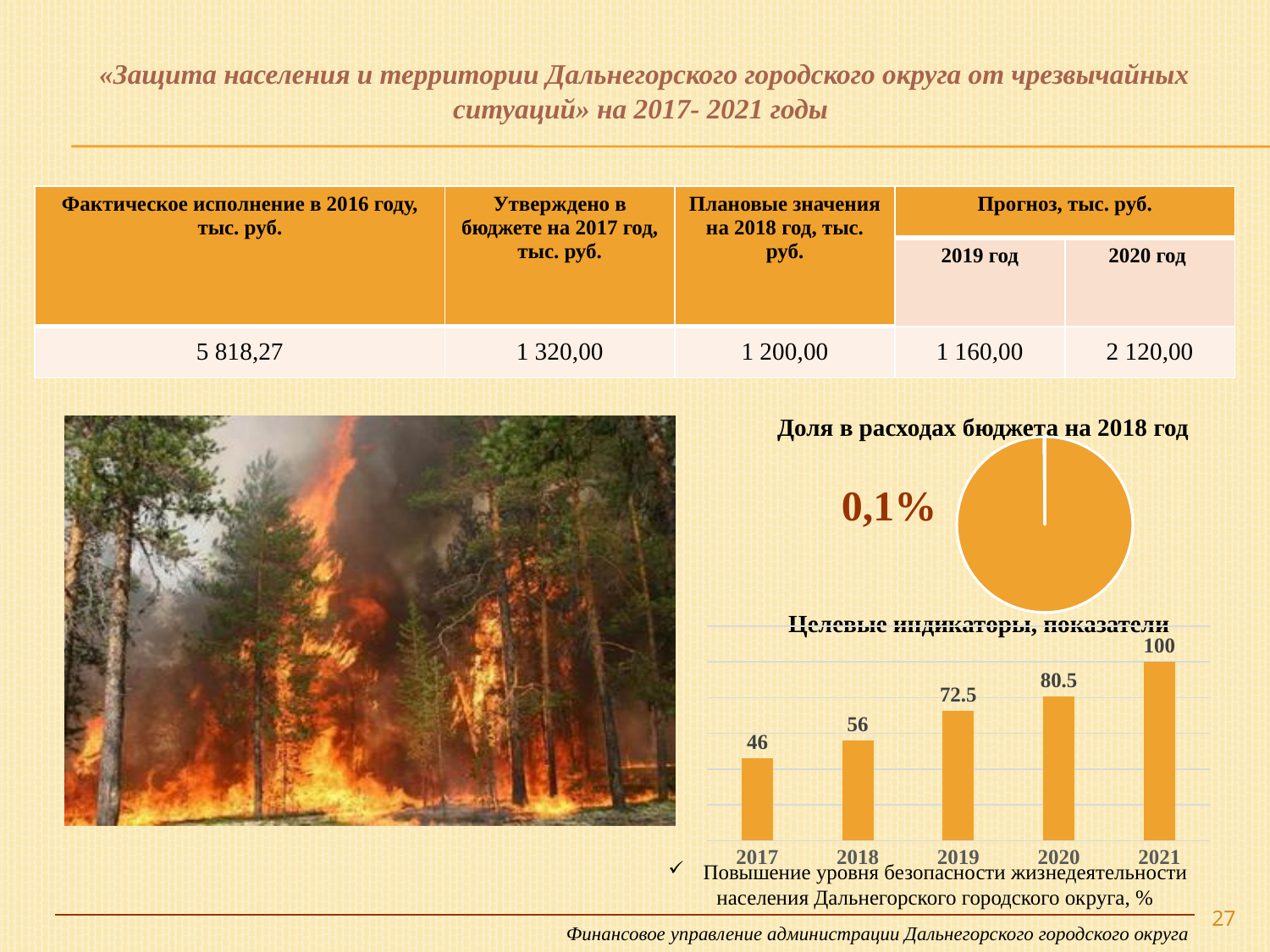
In the chart titled "Целевые индикаторы, показатели", what is the value for 2019? 72.5 In the chart titled "Целевые индикаторы, показатели", what is the value for 2021? 100 In the chart titled "Целевые индикаторы, показатели", what is the difference between the values for 2020 and 2019? 8 In the chart titled "Целевые индикаторы, показатели", which year has the highest value? 2021 What kind of chart is the one titled "Целевые индикаторы, показатели"? bar chart In the chart titled "Целевые индикаторы, показатели", do the values rise or fall from 2017 to 2021? rise What share is labelled on the pie chart titled "Доля в расходах бюджета на 2018 год"? 0,1% In the chart titled "Целевые индикаторы, показатели", which year has the lowest value? 2017 In the chart titled "Целевые индикаторы, показатели", what is the difference between the values for 2021 and 2017? 54 In the chart titled "Целевые индикаторы, показатели", how many years are shown on the x axis? 5 In the chart titled "Целевые индикаторы, показатели", which is larger, the value for 2018 or the value for 2020? 2020 In the chart titled "Целевые индикаторы, показатели", what is the value for 2017? 46